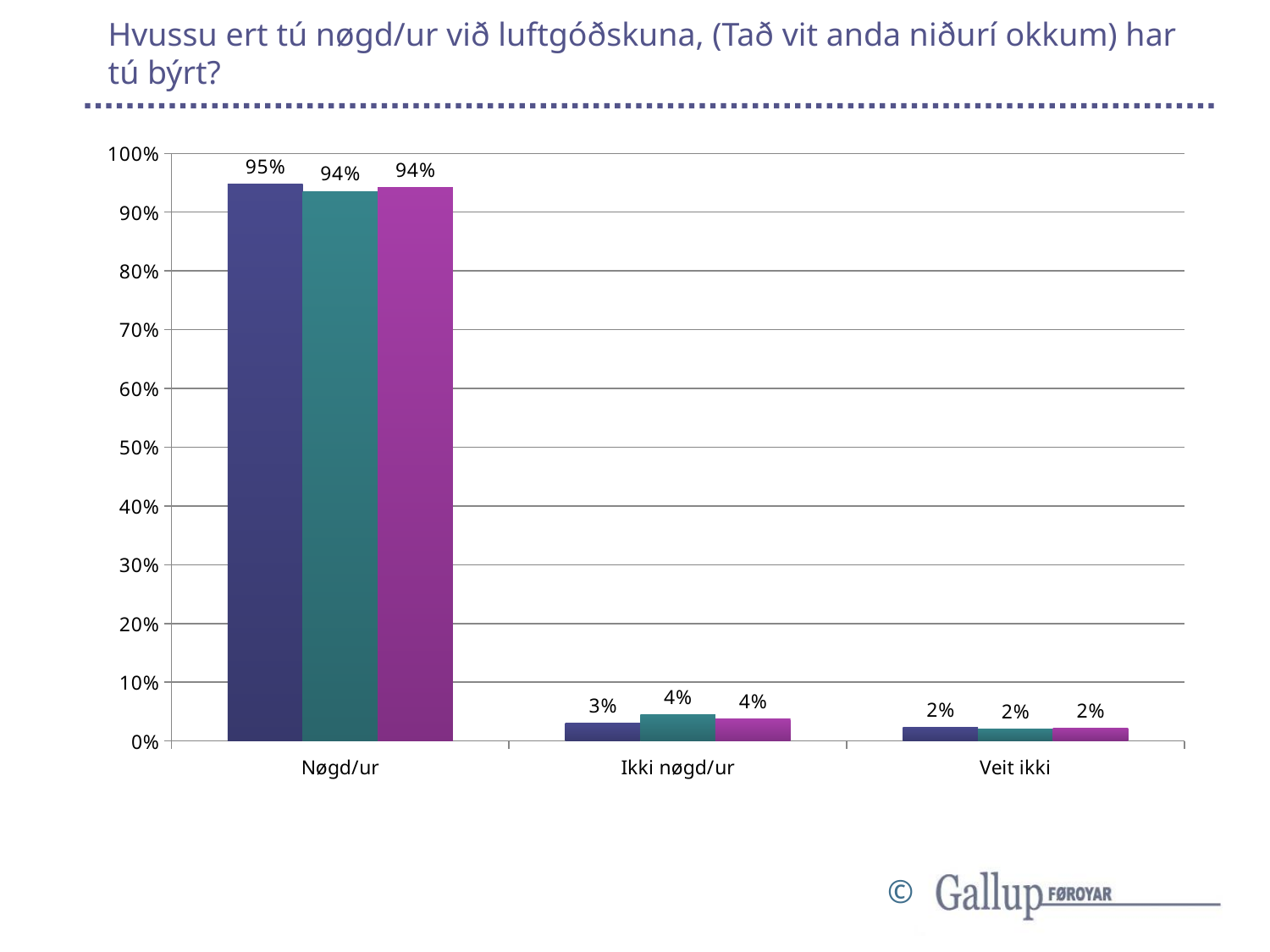
What is the value of the magenta bar for Ikki nøgd/ur? 4% What is the value of the teal bar for Veit ikki? 2% What kind of chart is shown on the slide? bar chart What is the value of the dark blue bar for Ikki nøgd/ur? 3% What is the value of the teal bar for Nøgd/ur? 94% Which category has the lowest values? Veit ikki How many categories are shown on the x axis? 3 What is the value of the dark blue bar for Nøgd/ur? 95% Which category has the highest values? Nøgd/ur What is the difference between the dark blue bar for Nøgd/ur and the dark blue bar for Ikki nøgd/ur? 92 percentage points Is the value of the magenta bar for Nøgd/ur greater or less than 90%? greater How many bars are plotted for each category? 3